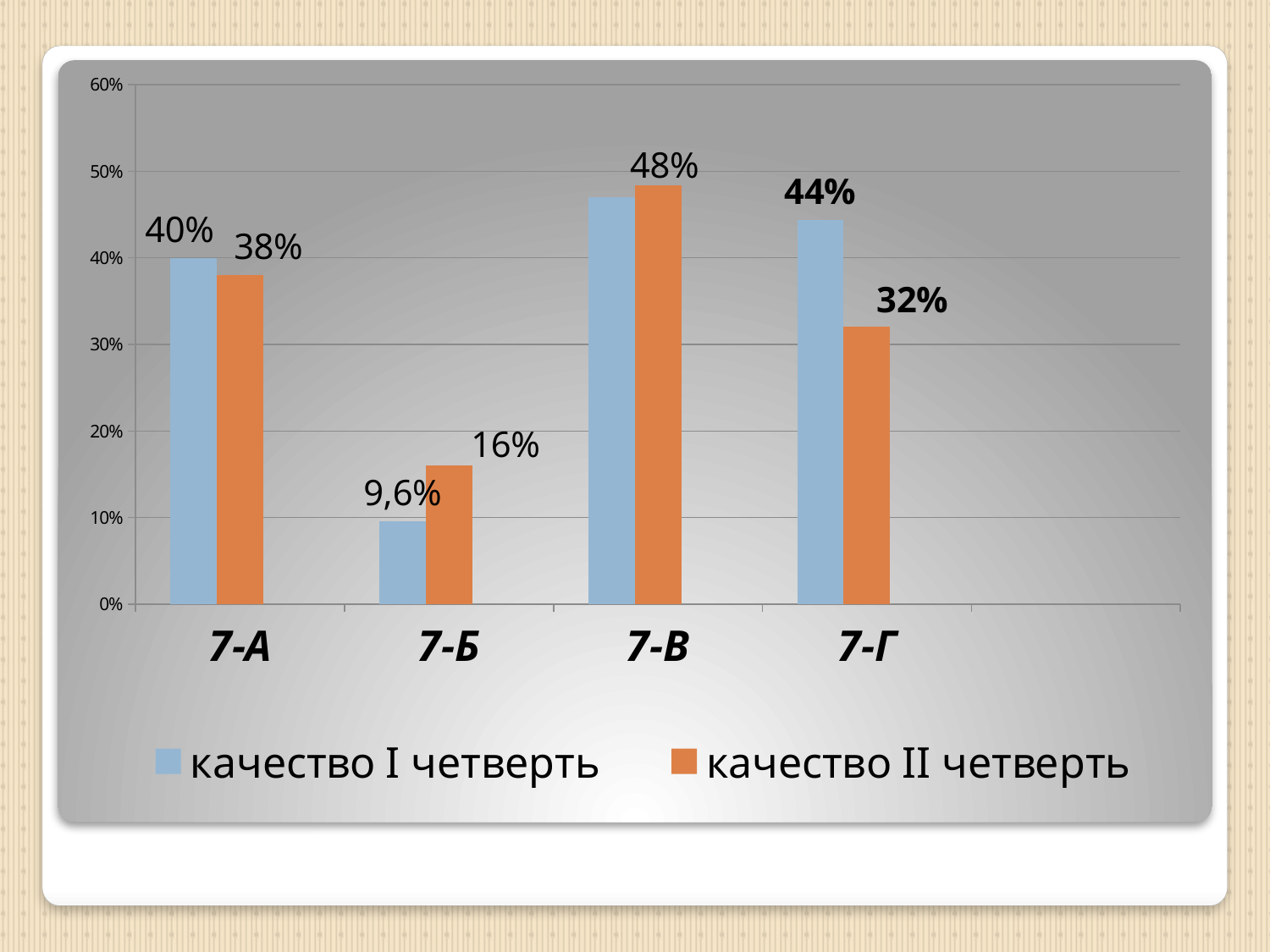
What is the value of качество II четверть for 7-Б? 16% For 7-А, which is larger: качество I четверть or качество II четверть? качество I четверть What is the value of качество II четверть for 7-Г? 32% What type of chart is shown on the slide? bar chart What is the difference between качество I четверть and качество II четверть for 7-Г? 12% Which class has the lowest value for качество I четверть? 7-Б How many series does the legend list? 2 How many classes (categories) are shown on the x axis? 4 What is the value of качество I четверть for 7-А? 40% What is the value of качество I четверть for 7-Б? 9,6% Which class has the highest value for качество II четверть? 7-В Is the value of качество I четверть for 7-В greater or less than 40%? greater